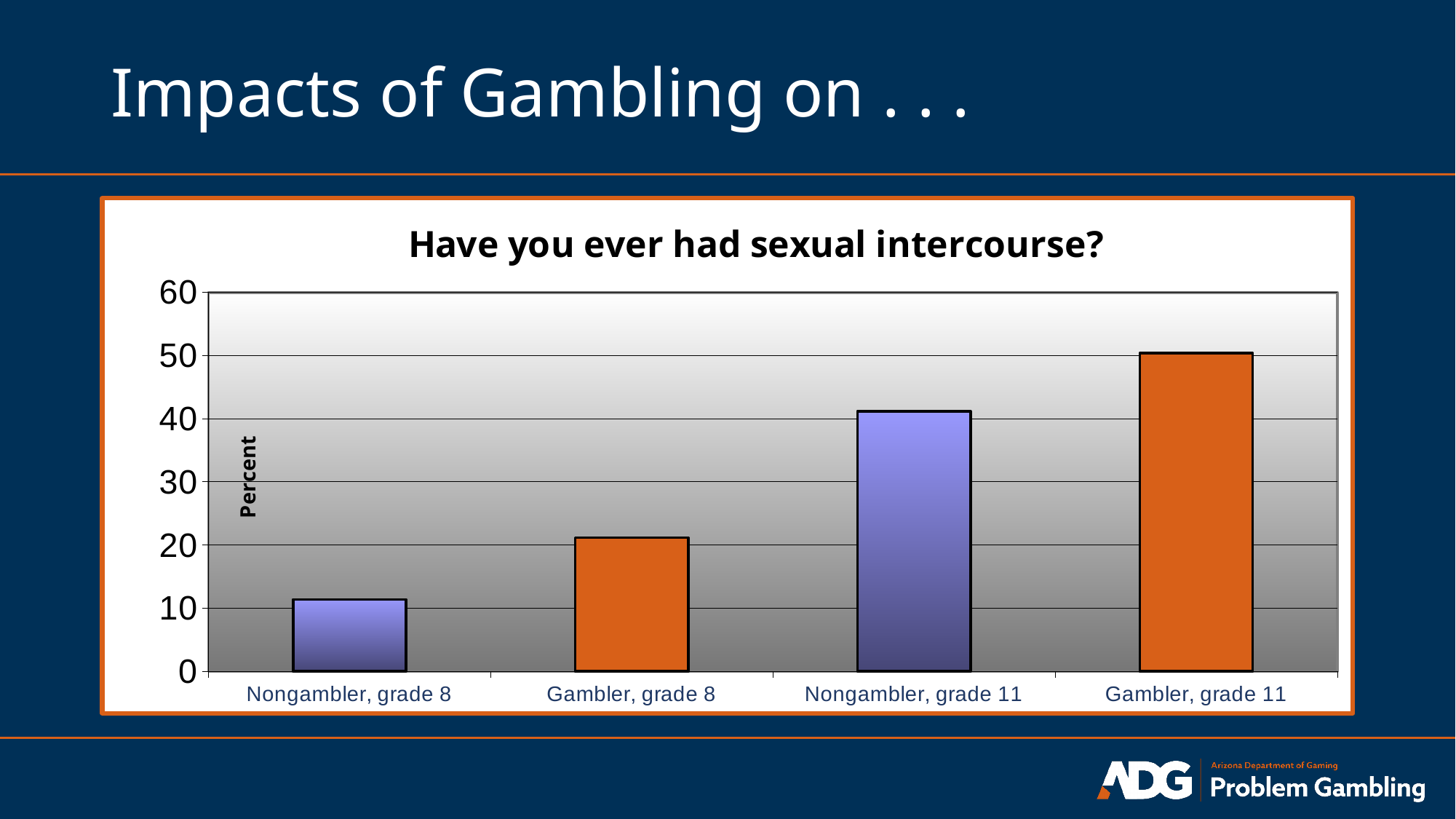
Is the value for Gambler, grade 8 greater or less than 30? less Do the values rise or fall from left to right across the categories? rise What is the title of the chart? Have you ever had sexual intercourse? Is the value for Gambler, grade 11 greater or less than 40? greater What label is shown on the vertical axis? Percent How many categories are plotted on the chart? 4 Which is larger, the value for Gambler, grade 8 or the value for Nongambler, grade 11? Nongambler, grade 11 Is the value for Nongambler, grade 8 greater or less than 20? less Which category has the lowest value? Nongambler, grade 8 What kind of chart is shown on the slide? bar chart Which category has the highest value? Gambler, grade 11